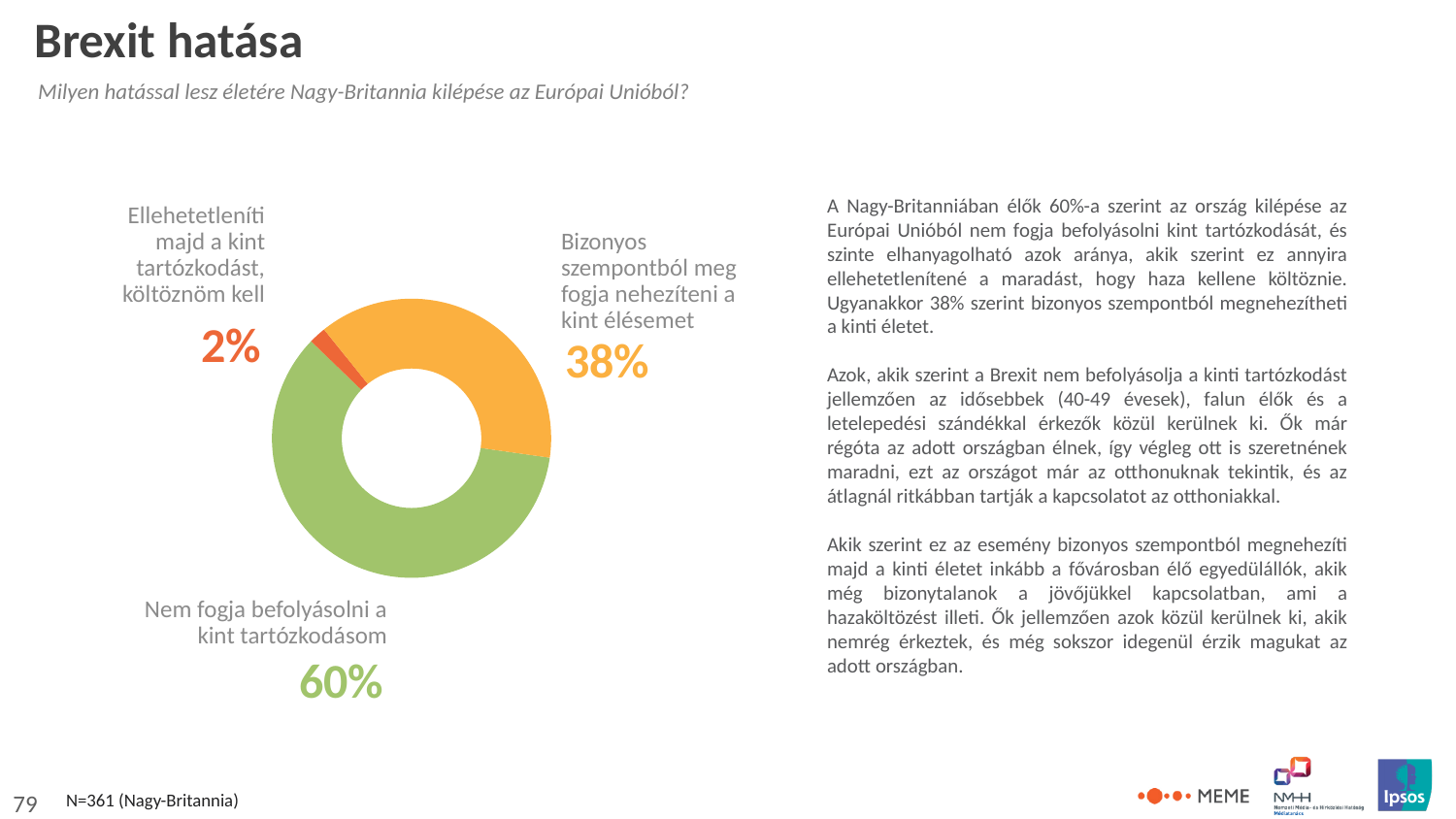
Which is larger: the share for "Bizonyos szempontból meg fogja nehezíteni" or the share for "Ellehetetleníti majd a kint tartózkodást"? Bizonyos szempontból meg fogja nehezíteni What share of respondents said Brexit will not affect their stay abroad ("Nem fogja befolyásolni a kint tartózkodásom")? 60% What kind of chart is shown on the slide? Doughnut (pie) chart What is the sample size (N) stated at the bottom of the slide? N=361 (Nagy-Britannia) What is the difference in percentage points between the "Nem fogja befolyásolni" share and the "Bizonyos szempontból meg fogja nehezíteni" share? 22 percentage points Which category has the smallest share in the chart? Ellehetetleníti majd a kint tartózkodást, költöznöm kell What is the total of the three shares shown in the chart? 100% How many categories does the chart show? 3 What share of respondents said Brexit will make life abroad harder in some respects ("Bizonyos szempontból meg fogja nehezíteni a kint élésemet")? 38% What share of respondents said they would have to move home ("Ellehetetleníti majd a kint tartózkodást, költöznöm kell")? 2% What colour is the slice for "Nem fogja befolyásolni a kint tartózkodásom"? Green Which category has the largest share in the chart? Nem fogja befolyásolni a kint tartózkodásom